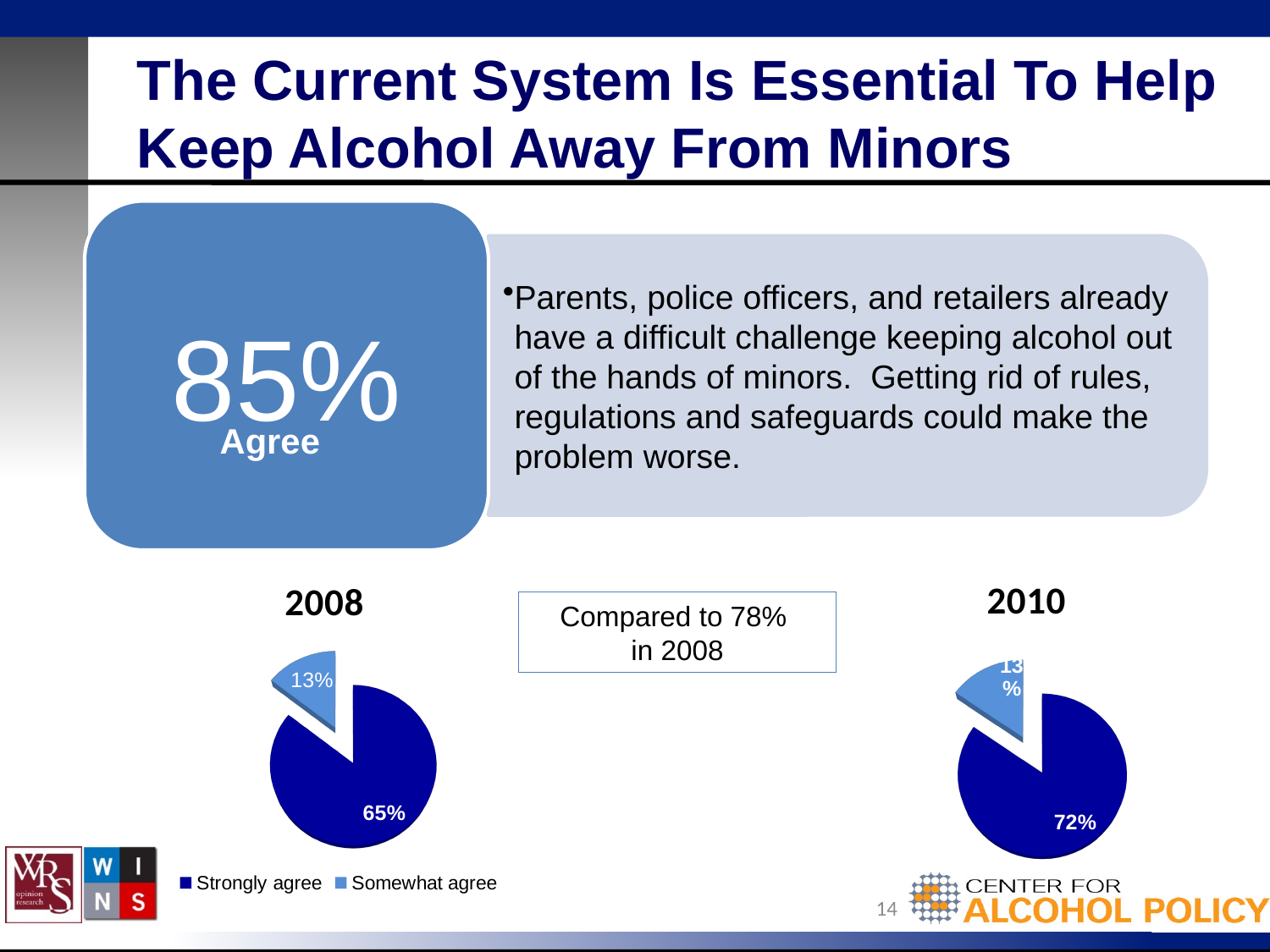
In the 2008 pie chart, what percentage is shown for Strongly agree? 65% How many pie charts are shown on the slide? 2 In the 2010 pie chart, which slice is the largest? Strongly agree In the 2010 pie chart, what percentage is shown for Strongly agree? 72% In the 2008 pie chart, what percentage is shown for Somewhat agree? 13% What is the difference between the Strongly agree share in 2010 and the Strongly agree share in 2008? 7 percentage points What are the two legend entries for the pie charts? Strongly agree and Somewhat agree What type of chart is used to show the 2008 and 2010 results? Pie chart How many series does the legend list for the pie charts? 2 In the 2008 pie chart, which slice is the smallest? Somewhat agree What is the title of the pie chart on the left? 2008 Is the Strongly agree share larger in the 2008 pie chart or the 2010 pie chart? 2010